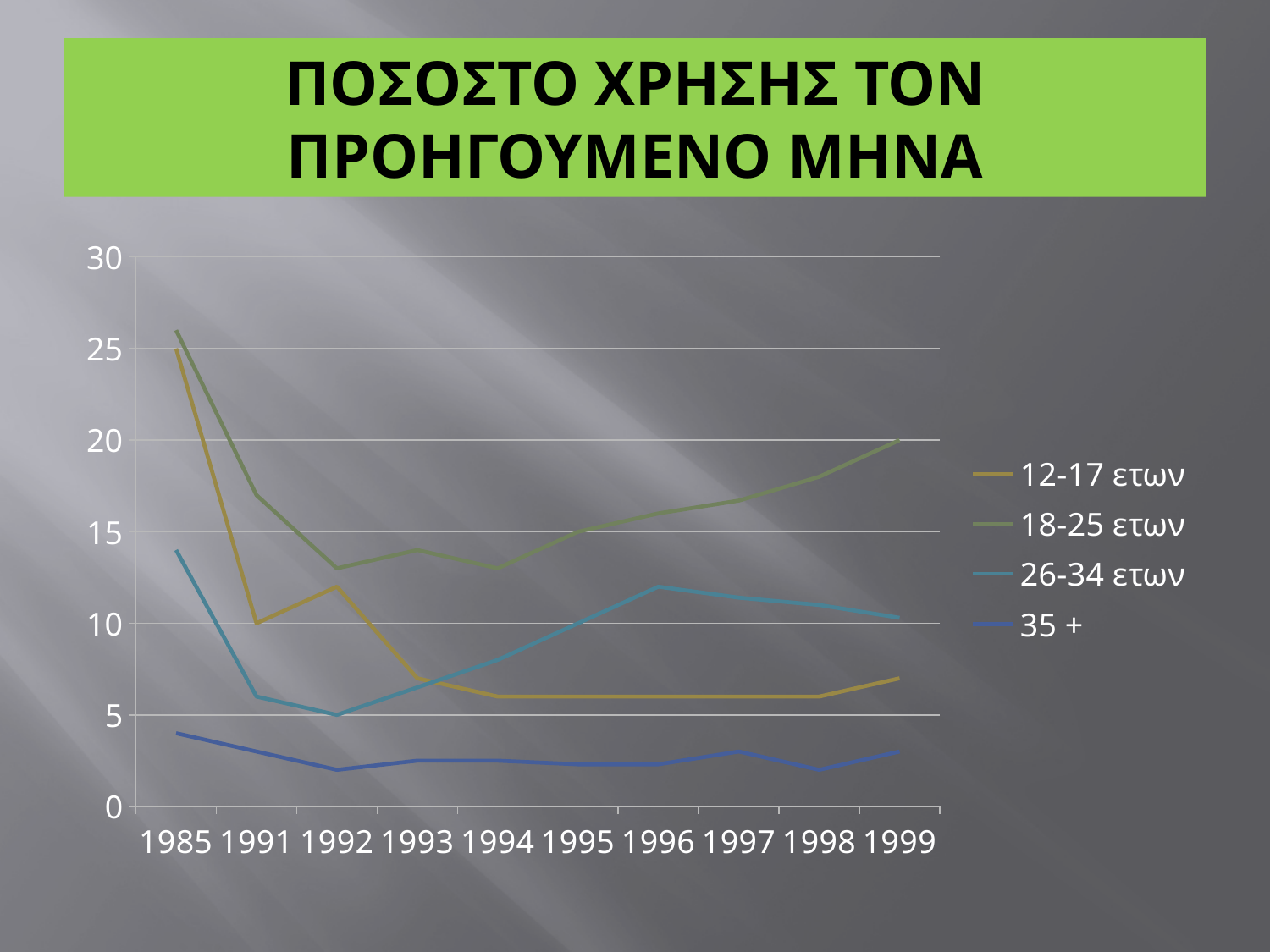
Which series has the highest value in 1999? 18-25 ετων How many years are shown on the x axis? 10 Which series has the lowest value in 1985? 35 + What is the value for the 12-17 ετων series in 1985? 25 What kind of chart is shown on the slide? line chart Does the 18-25 ετων series rise or fall from 1992 to 1999? rise How many series does the legend list? 4 What is the value for the 18-25 ετων series in 1999? 20 Is the value for the 26-34 ετων series in 1996 greater or less than 10? greater Is the value for the 18-25 ετων series in 1985 greater or less than 25? greater What is the value for the 12-17 ετων series in 1991? 10 Is the value for the 35 + series in 1985 greater or less than 5? less